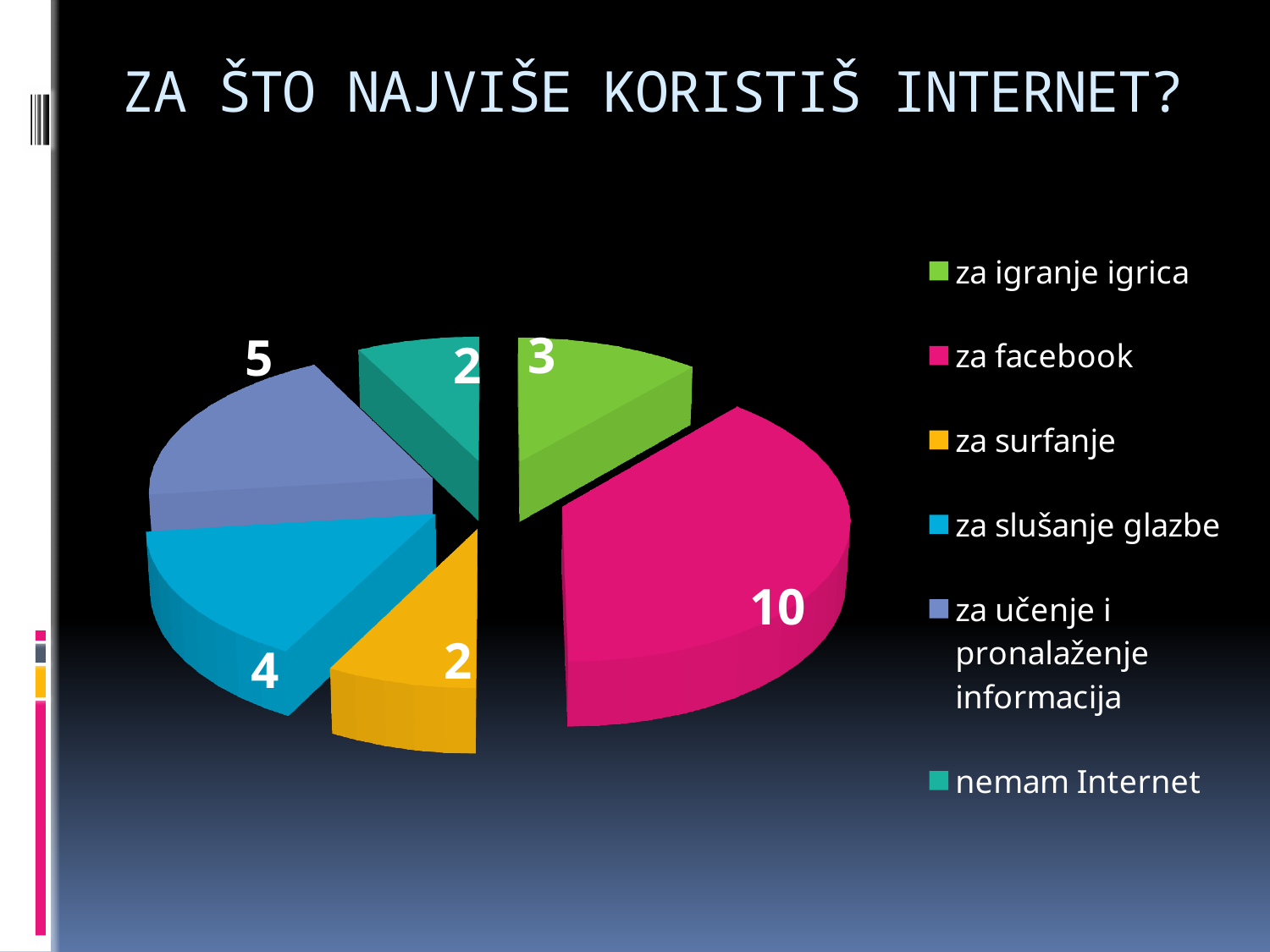
What is the value for "za igranje igrica"? 3 What is the value for "za slušanje glazbe"? 4 Which category has the largest slice of the pie? za facebook What is the value for "nemam Internet"? 2 What is the value for "za facebook"? 10 Which is larger, the value for "za slušanje glazbe" or the value for "za igranje igrica"? za slušanje glazbe What colour is the slice for "za surfanje"? yellow What is the value for "za učenje i pronalaženje informacija"? 5 What is the total of all the values shown in the pie chart? 26 What type of chart is shown on the slide? pie chart What is the difference between the values for "za facebook" and "za učenje i pronalaženje informacija"? 5 How many categories does the pie chart have? 6